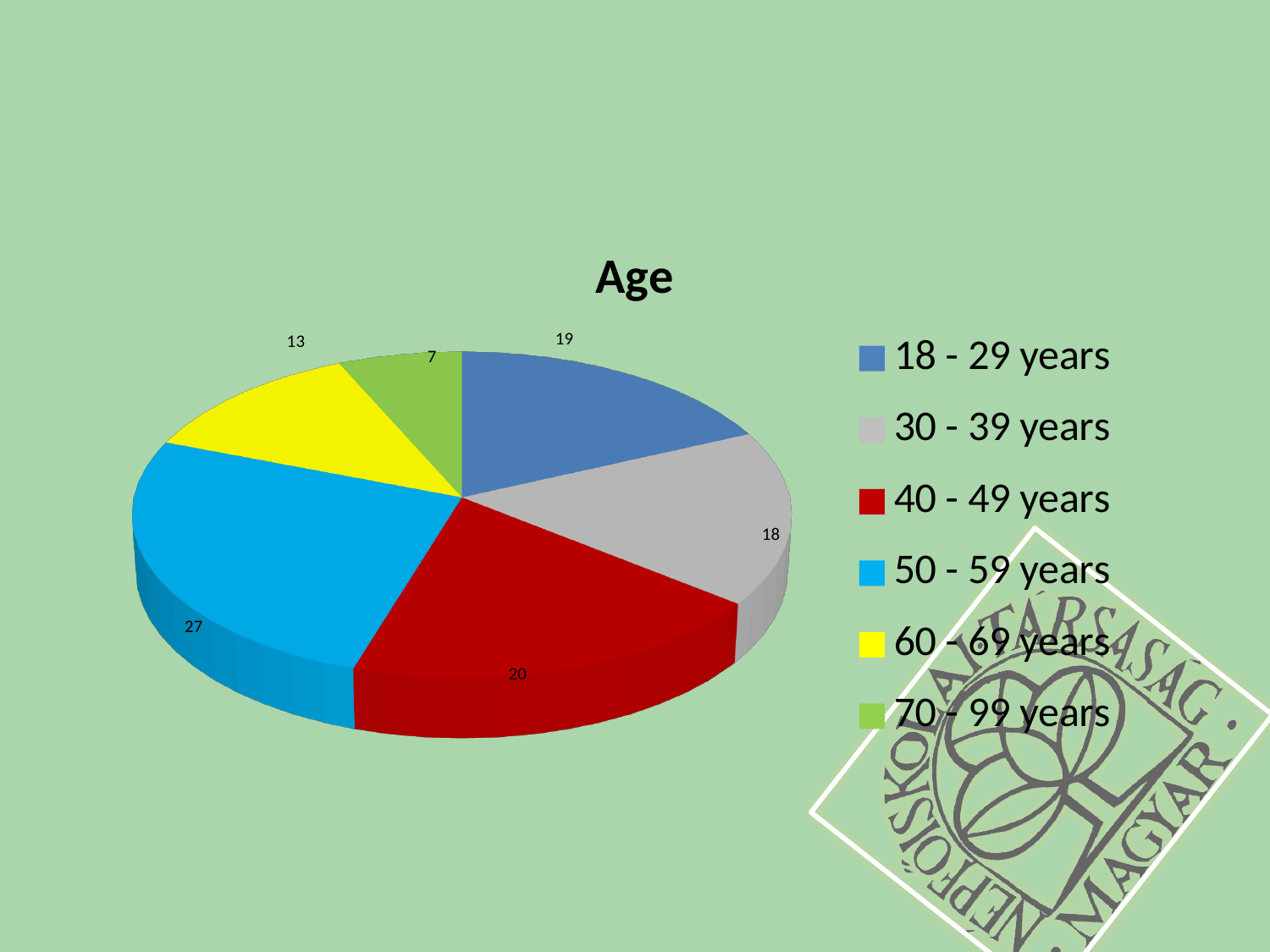
What is the value for the 70 - 99 years slice? 7 What colour is the 60 - 69 years slice? Yellow What type of chart is shown on the slide? Pie chart What is the title of the chart? Age How many age groups are shown in the pie chart? 6 Which age group has the smallest slice? 70 - 99 years What is the difference between the values for 50 - 59 years and 40 - 49 years? 7 Which age group has the largest slice? 50 - 59 years What is the value for the 50 - 59 years slice? 27 Which is larger, the value for 40 - 49 years or the value for 30 - 39 years? 40 - 49 years What is the value for the 18 - 29 years slice? 19 What is the value for the 60 - 69 years slice? 13